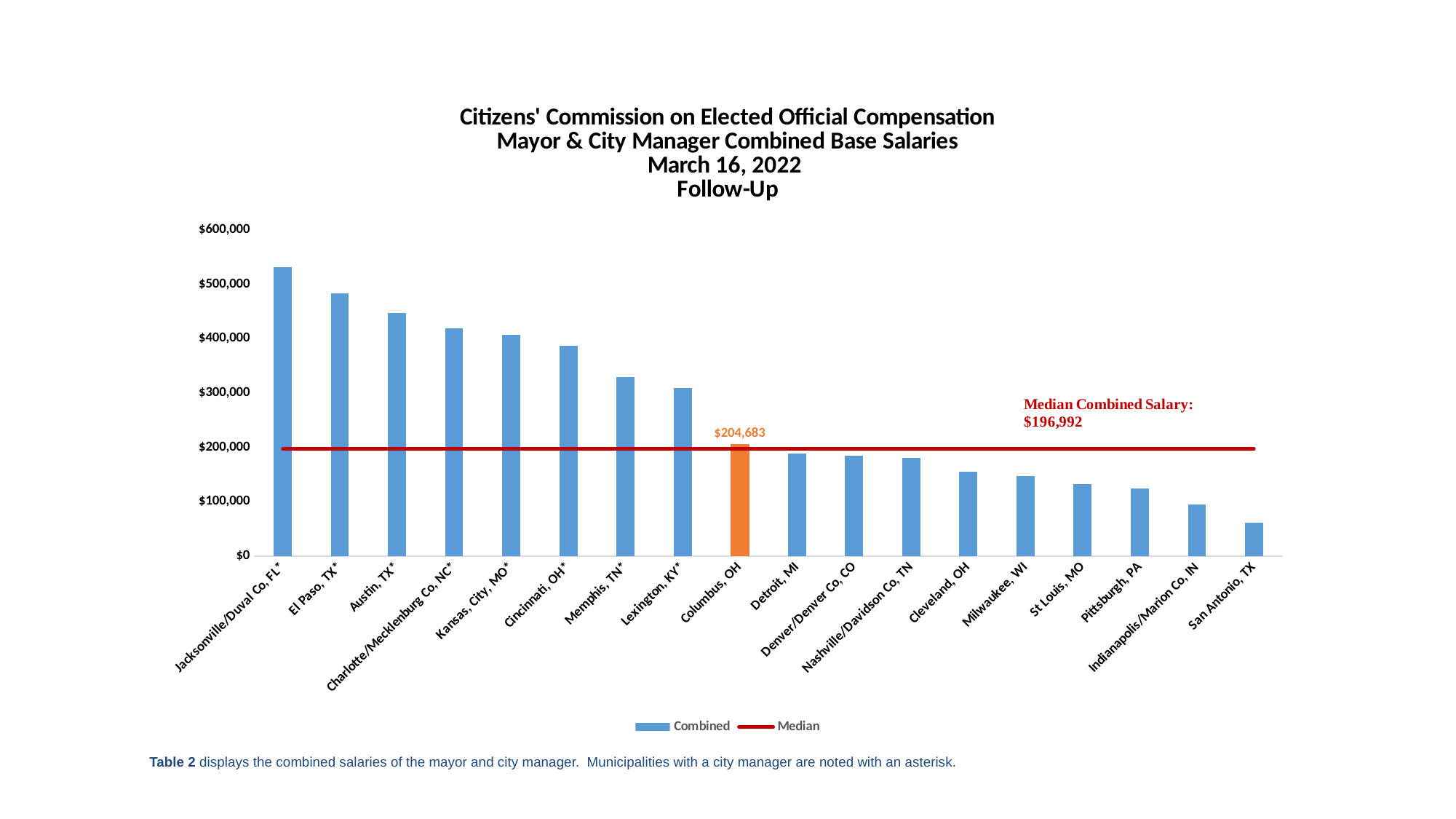
Which has the larger combined base salary, El Paso, TX* or Austin, TX*? El Paso, TX* How many entries does the legend list? 2 Is the value for San Antonio, TX greater or less than $100,000? less What is the combined base salary shown for Columbus, OH? $204,683 How many municipalities are shown on the x axis? 18 Is the value for Jacksonville/Duval Co, FL* greater or less than $500,000? greater Do the bar values rise or fall moving from left to right along the x axis? Fall What type of chart is shown on the slide? Bar chart Is the value for Memphis, TN* greater or less than $300,000? greater Which municipality has the highest combined base salary? Jacksonville/Duval Co, FL* What is the median combined salary shown on the chart? $196,992 Which municipality has the lowest combined base salary? San Antonio, TX